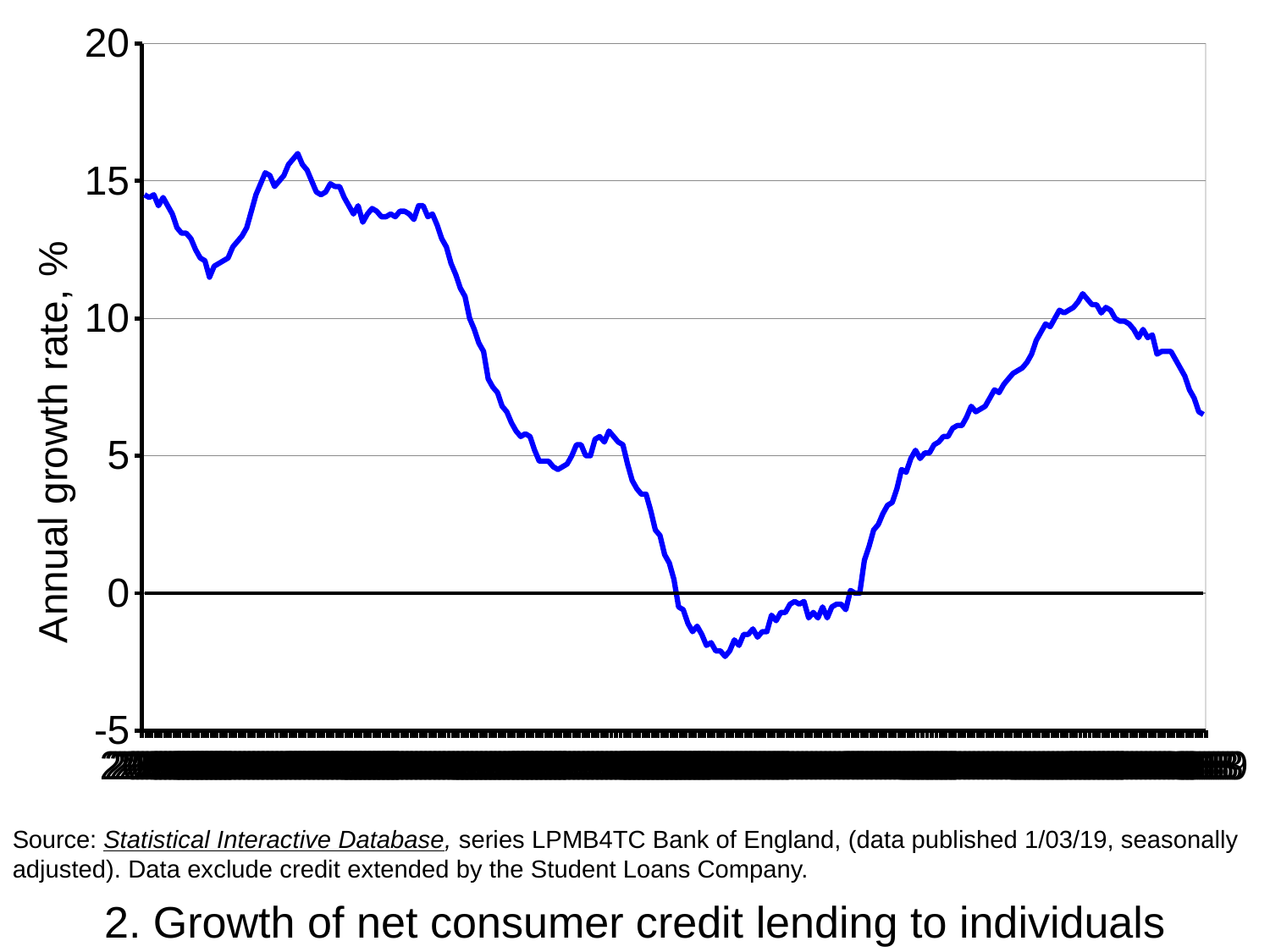
What is the title of the chart? 2. Growth of net consumer credit lending to individuals What is the highest value shown on the vertical axis? 20 Is the highest point reached by the line greater or less than 15? greater Is the value at the right-hand end of the line greater or less than 5? greater Is the lowest point reached by the line greater or less than 0? less Comparing the start and the end of the line, is the value at the start or at the end larger? start What kind of chart is shown on the slide? line chart What is the label on the vertical axis of the chart? Annual growth rate, %